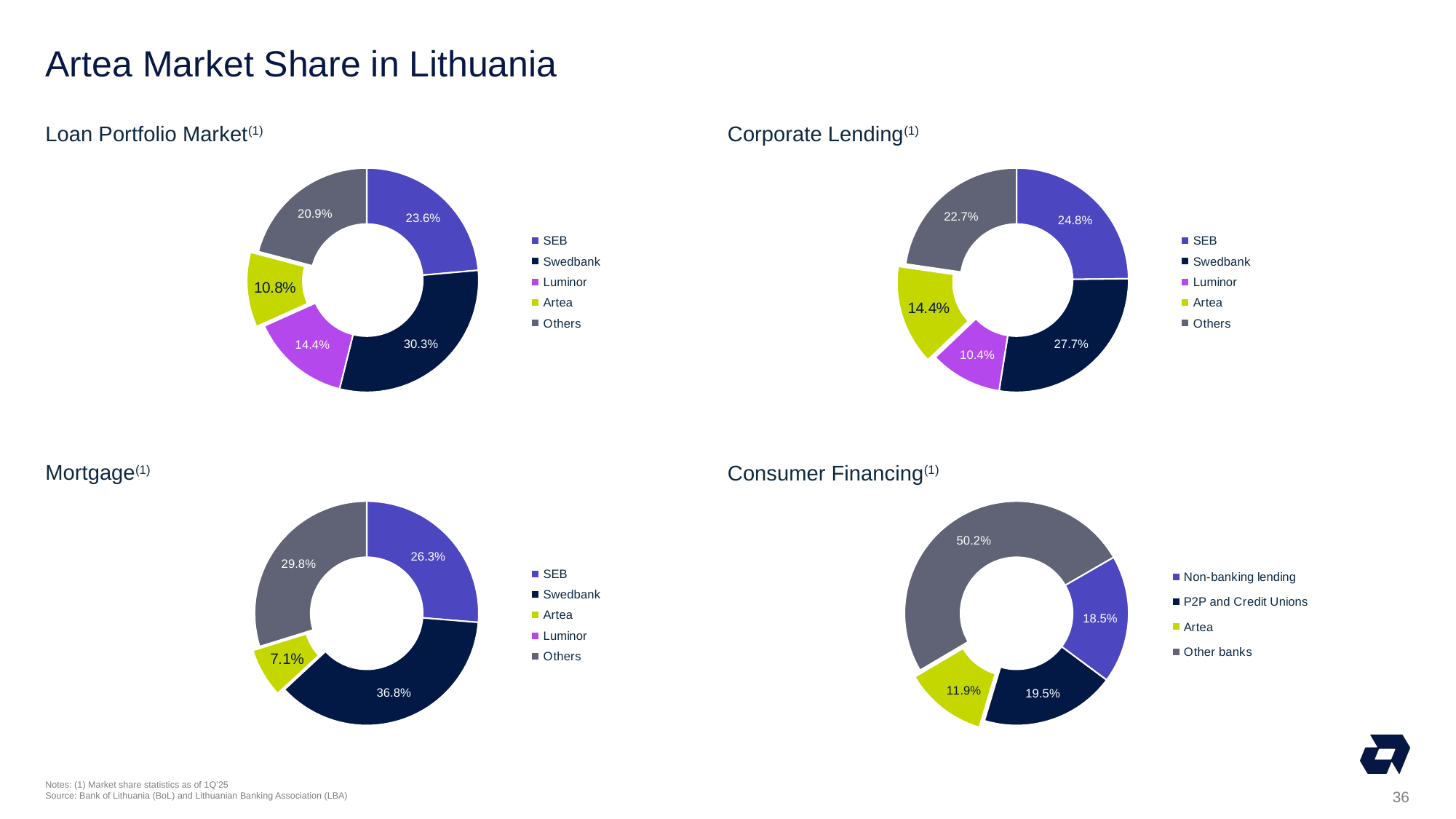
In the Corporate Lending chart, which is larger, SEB or Others? SEB In the Consumer Financing chart, what is the difference between P2P and Credit Unions and Non-banking lending? 1.0 percentage point In the Loan Portfolio Market chart, which category has the largest share? Swedbank In the Corporate Lending chart, what is Artea's share? 14.4% In the Loan Portfolio Market chart, what is the difference between Swedbank's and SEB's shares? 6.7 percentage points In the Corporate Lending chart, which category has the smallest share? Luminor In the Mortgage chart, what is Swedbank's share? 36.8% In the Loan Portfolio Market chart, what is Artea's share? 10.8% What type of chart is used for the Mortgage market share? Pie (donut) chart In the Consumer Financing chart, what is the share for Other banks? 50.2% In the Mortgage chart, what is Artea's share? 7.1% How many entries does the legend of the Consumer Financing chart list? 4